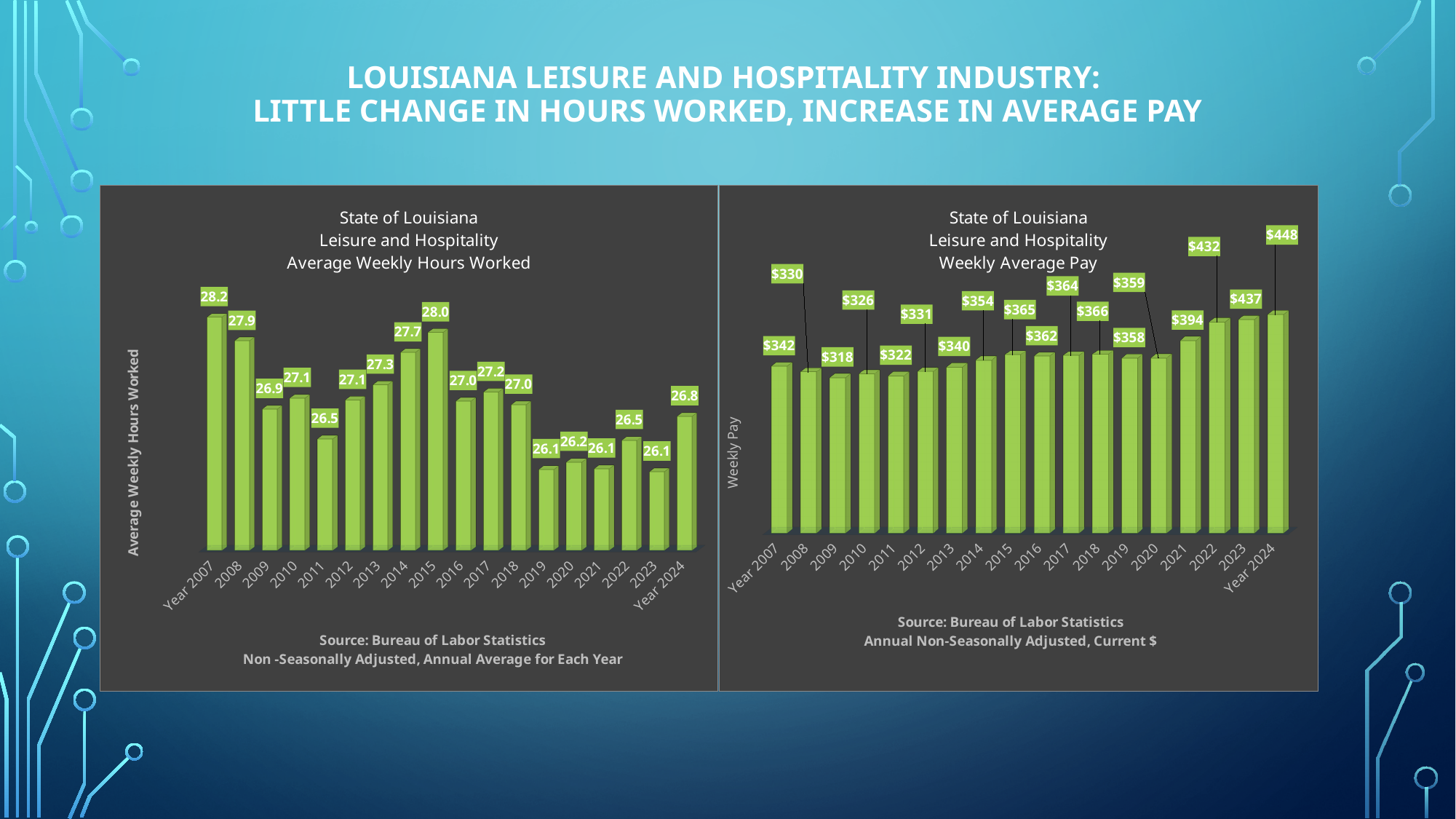
In the Average Weekly Hours Worked chart, what is the difference between the 2007 value and the 2011 value? 1.7 What kind of chart is the Weekly Average Pay chart? Bar chart In the Average Weekly Hours Worked chart, how many years are plotted? 18 In the Weekly Average Pay chart, what is the difference between the 2024 value and the 2007 value? $106 In the Weekly Average Pay chart, do values generally rise or fall from 2020 to 2024? Rise In the Average Weekly Hours Worked chart, which year had the highest average weekly hours? 2007 In the Weekly Average Pay chart, which year had the lowest weekly average pay? 2009 In the Weekly Average Pay chart, which is larger, the value for 2016 or the value for 2018? 2018 In the Average Weekly Hours Worked chart, what was the value for 2015? 28.0 In the Weekly Average Pay chart, which year had the highest weekly average pay? Year 2024 In the Weekly Average Pay chart, what was the weekly average pay in 2021? $394 In the Average Weekly Hours Worked chart, what is the value for Year 2024? 26.8